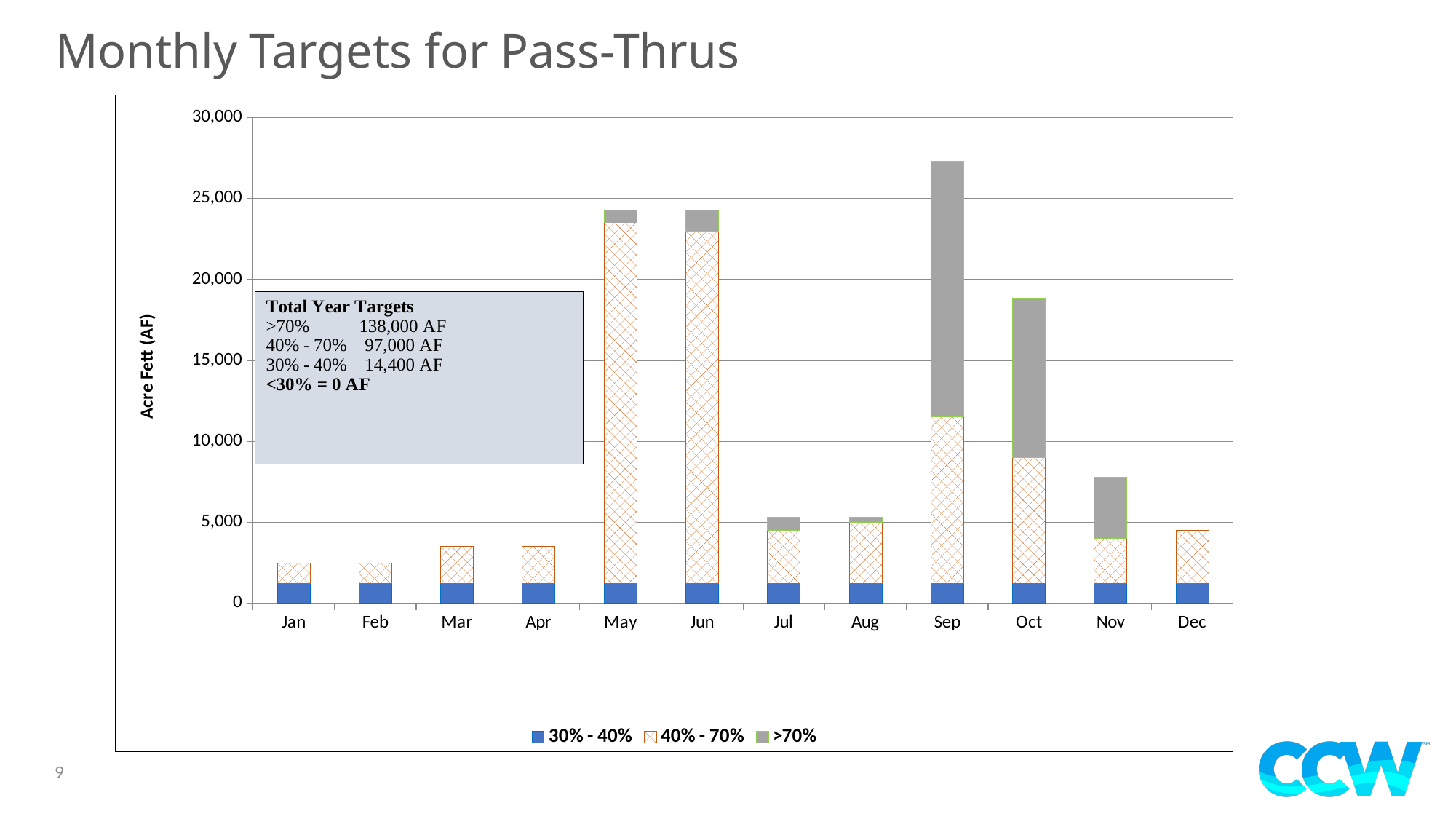
How many months are shown along the x axis of the chart? 12 Is the total value for Jan greater or less than 5,000? less How many series does the chart legend list? 3 What kind of chart is shown on the slide? Stacked bar chart Which month has the largest >70% segment? Sep Is the total value for Sep greater or less than 25,000? greater According to the Total Year Targets box, what is the total year target for >70%? 138,000 AF Is the total value for Nov greater or less than 5,000? greater Which month has the larger total bar, Sep or Oct? Sep What is the label on the y axis of the chart? Acre Fett (AF) Which month has the highest total bar in the chart? Sep